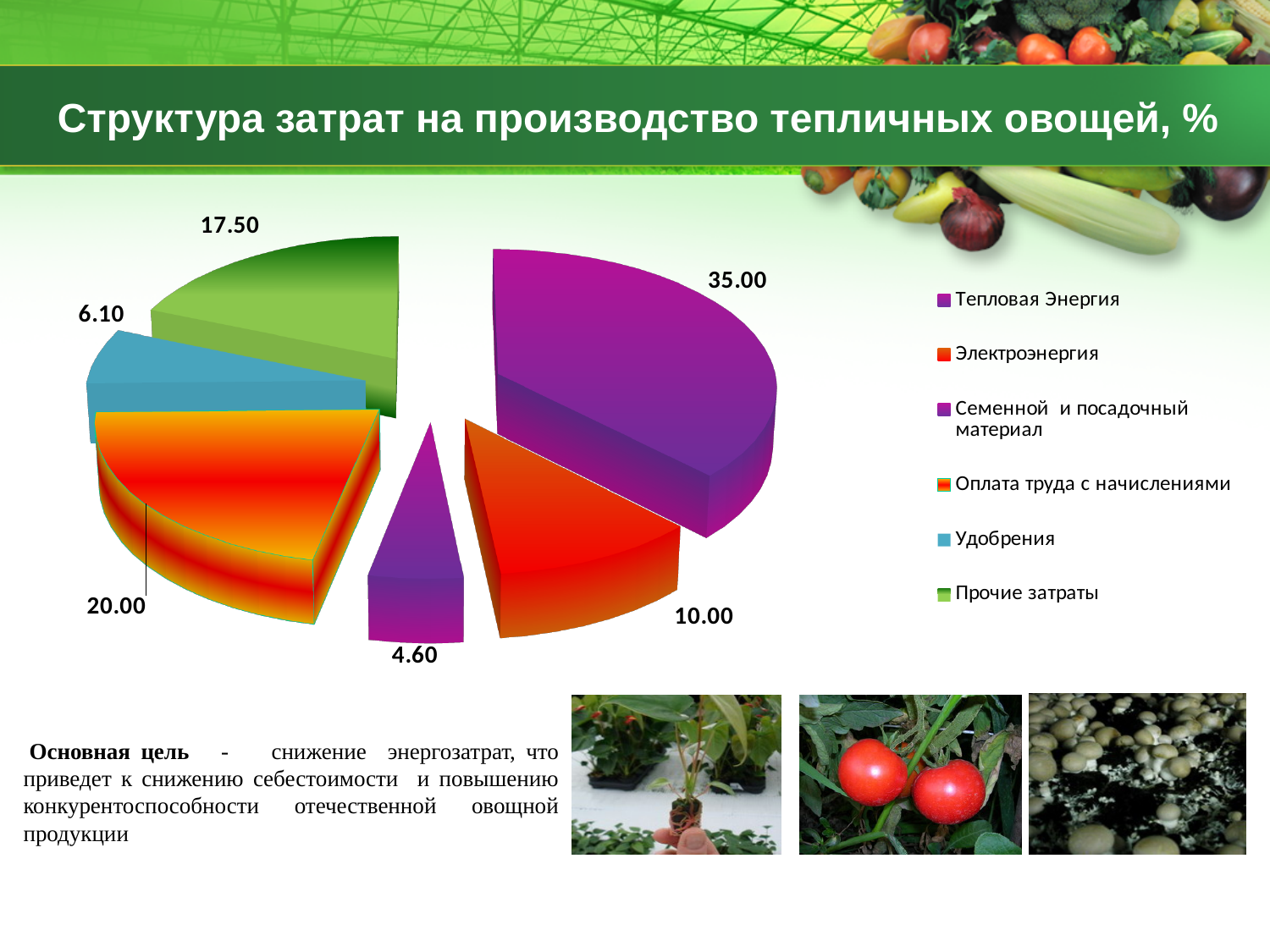
Which category has the smallest slice of the pie? Семенной и посадочный материал What is the value for Семенной и посадочный материал? 4.60 What is the value for Тепловая Энергия? 35.00 What is the difference between the values for Тепловая Энергия and Электроэнергия? 25.00 Which is larger, the value for Прочие затраты or the value for Электроэнергия? Прочие затраты Which category has the largest slice of the pie? Тепловая Энергия What is the value for Оплата труда с начислениями? 20.00 What is the title of the chart? Структура затрат на производство тепличных овощей, % How many categories does the legend of the pie chart list? 6 What colour is the slice for Удобрения? blue What kind of chart is shown on the slide? pie chart What is the value for Удобрения? 6.10